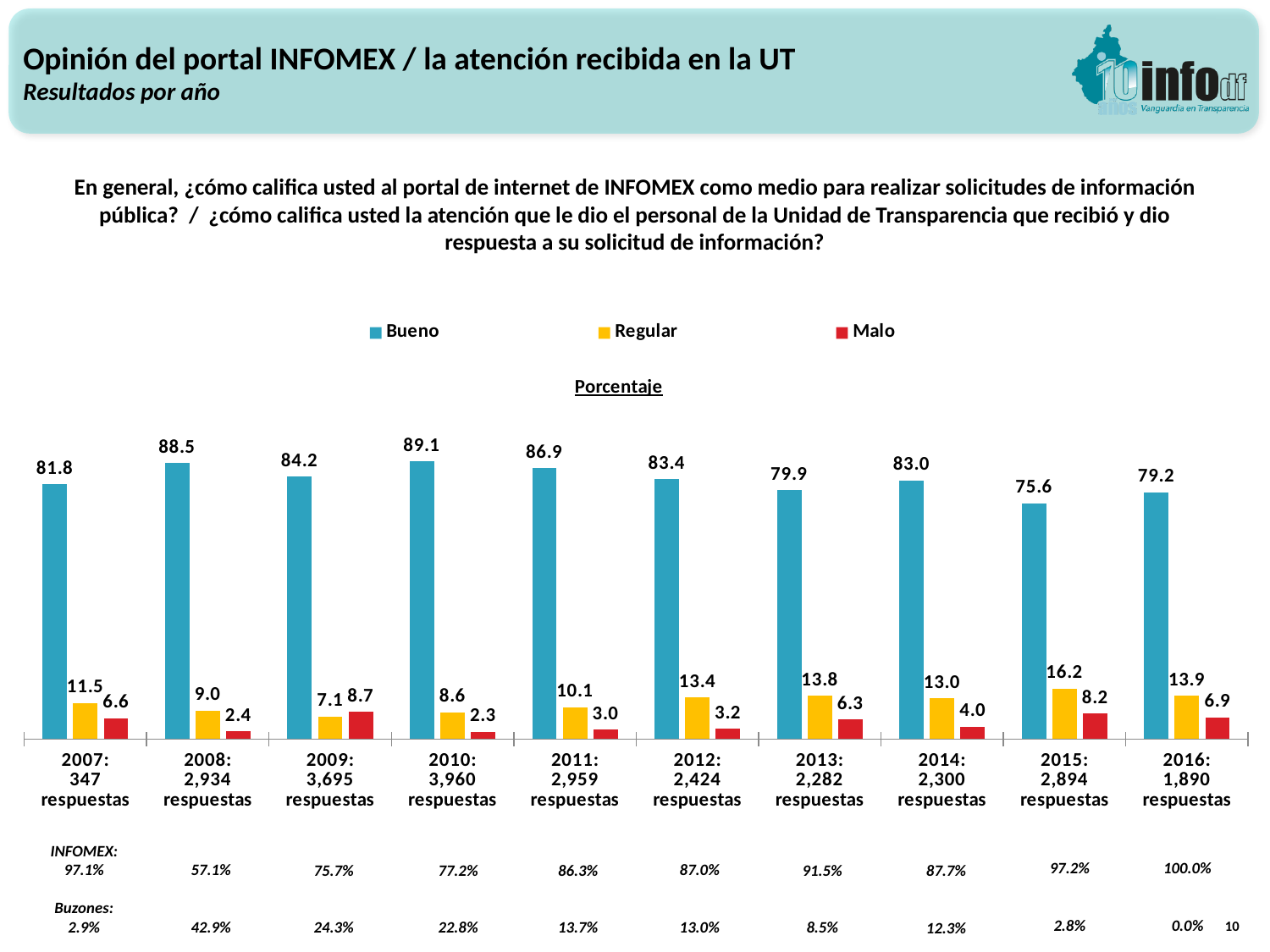
What is the Regular value for 2015? 16.2 What is the difference between the Bueno values for 2008 and 2016? 9.3 What kind of chart is shown on the slide? Bar chart Which year has the lowest Malo value? 2010 Which year has the highest Bueno value? 2010 How many years are shown on the x axis? 10 Which colour represents the Malo series in the legend? Red Which is larger, the Regular value for 2007 or the Regular value for 2011? 2007 What is the Malo value for 2009? 8.7 How many series does the legend list? 3 Which year has the lowest Bueno value? 2015 What is the Bueno value for 2010? 89.1